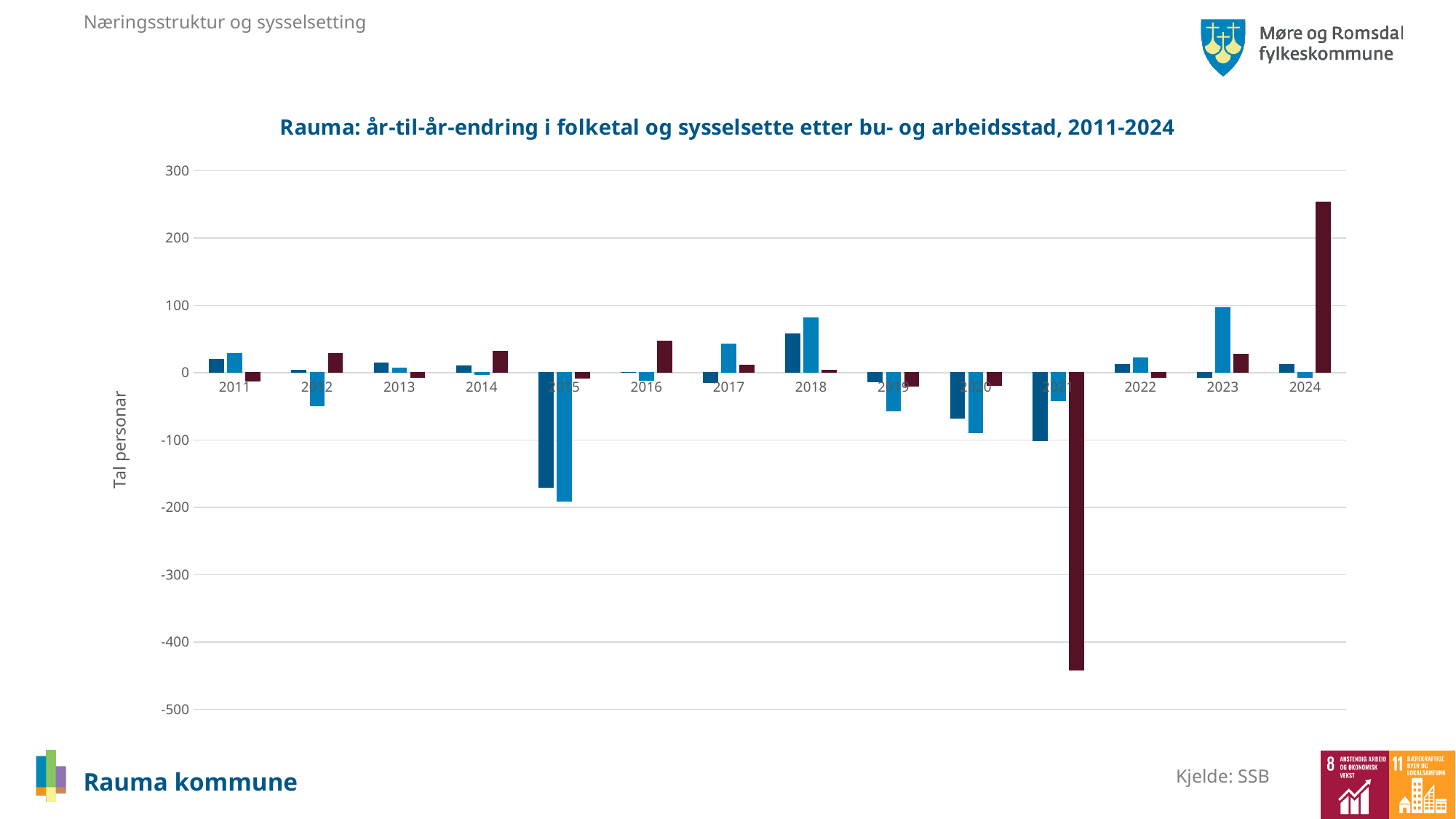
In which year is the dark red bar at its highest value? 2024 What is the label on the vertical axis of the chart? Tal personar Is the value of the dark red bar for 2024 greater or less than 200? greater Is the value of the light blue bar for 2015 greater or less than -100? less What is the title of the chart? Rauma: år-til-år-endring i folketal og sysselsette etter bu- og arbeidsstad, 2011-2024 Which is larger, the dark blue bar for 2015 or the dark blue bar for 2021? 2021 In which year is the dark red bar at its lowest value? 2021 Is the value of the light blue bar for 2023 greater or less than 50? greater In which year is the light blue bar at its lowest value? 2015 What kind of chart is shown on the slide? bar chart How many years are shown along the x axis of the chart? 14